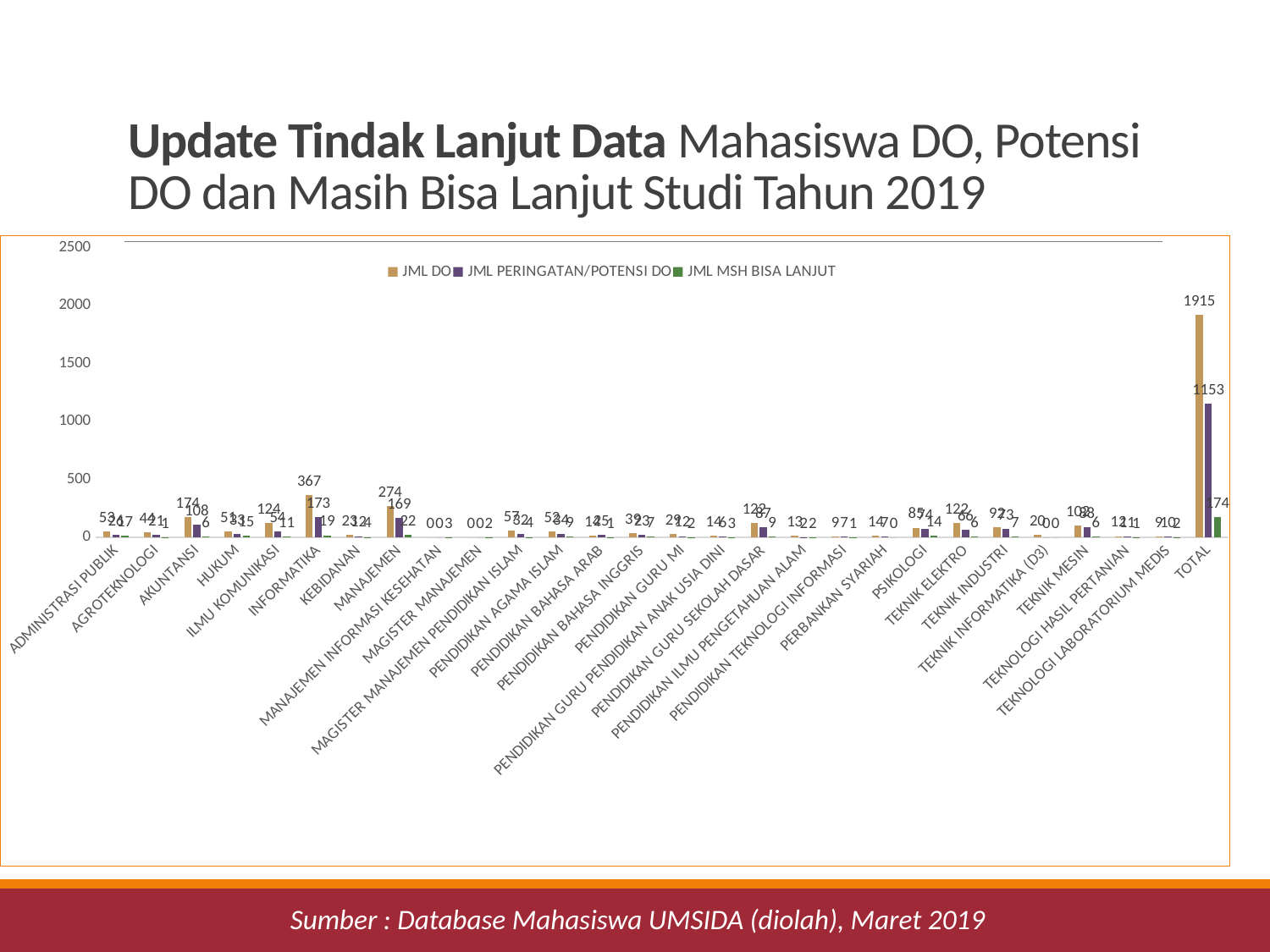
How many series does the legend list? 3 What is the difference between the JML DO values for INFORMATIKA and MANAJEMEN? 93 Which series is shown in green in the legend? JML MSH BISA LANJUT What is the difference between the JML DO and JML PERINGATAN/POTENSI DO values for TOTAL? 762 What kind of chart is shown on the slide? bar chart Is the JML PERINGATAN/POTENSI DO value for TOTAL greater or less than 1000? greater Which has the larger JML DO value, INFORMATIKA or MANAJEMEN? INFORMATIKA What is the JML DO value for INFORMATIKA? 367 What is the JML DO value for MANAJEMEN? 274 What is the JML DO value for TOTAL? 1915 Which category has the highest JML DO value? TOTAL What is the JML PERINGATAN/POTENSI DO value for TOTAL? 1153